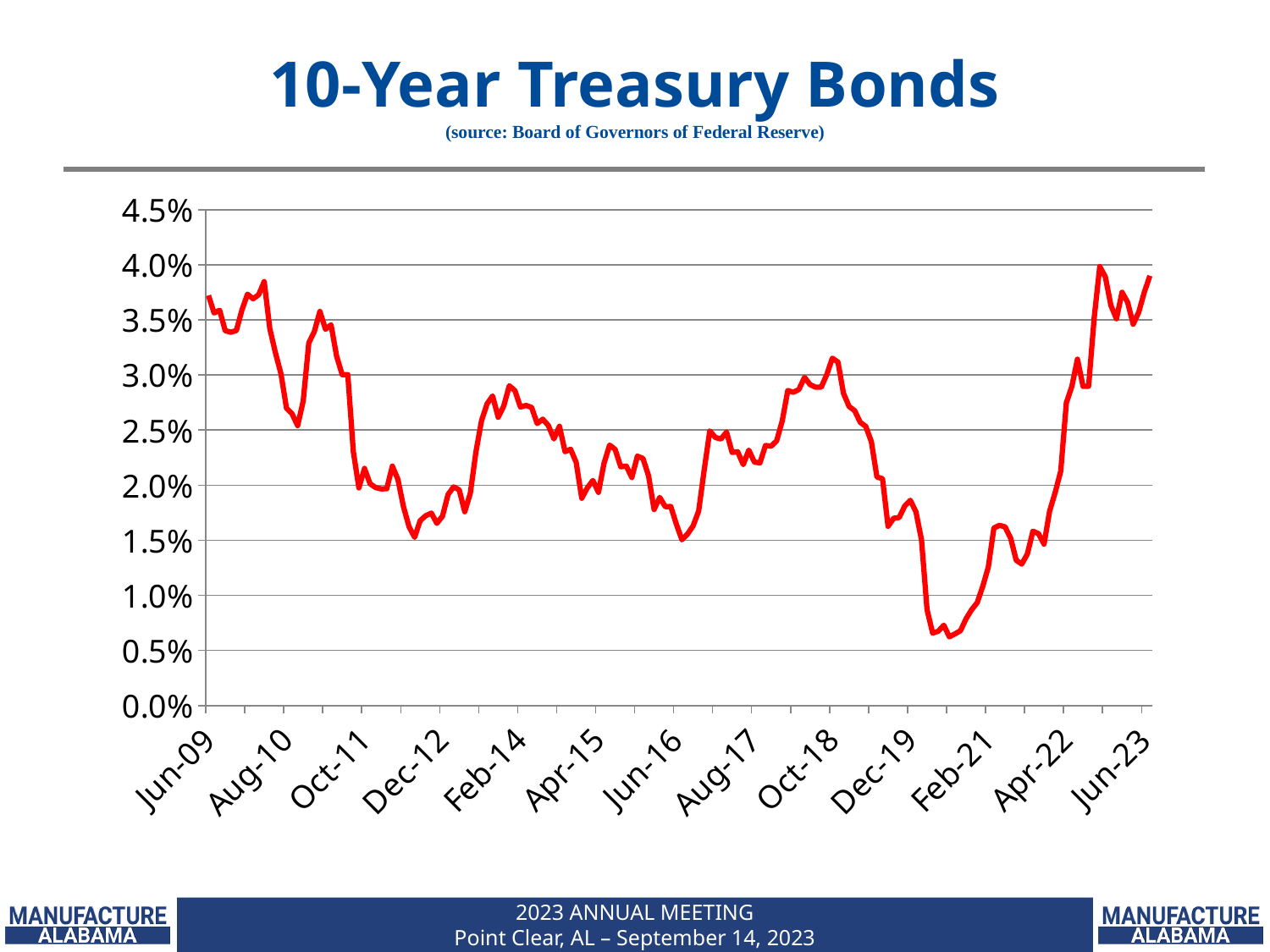
Is the value at Jun-09 greater or less than 3.0%? greater What is the title of the chart? 10-Year Treasury Bonds Does the line generally rise or fall between Apr-22 and Jun-23? Rise What kind of chart is shown on the slide? Line chart How many date labels are shown on the x axis? 13 What source is cited for the chart data? Board of Governors of Federal Reserve Is the value at Jun-16 greater or less than 2.0%? less Is the value at Dec-12 greater or less than 2.0%? less Between which two x-axis labels does the line reach its lowest point? Dec-19 and Feb-21 Does the line generally rise or fall between Oct-18 and Dec-19? Fall